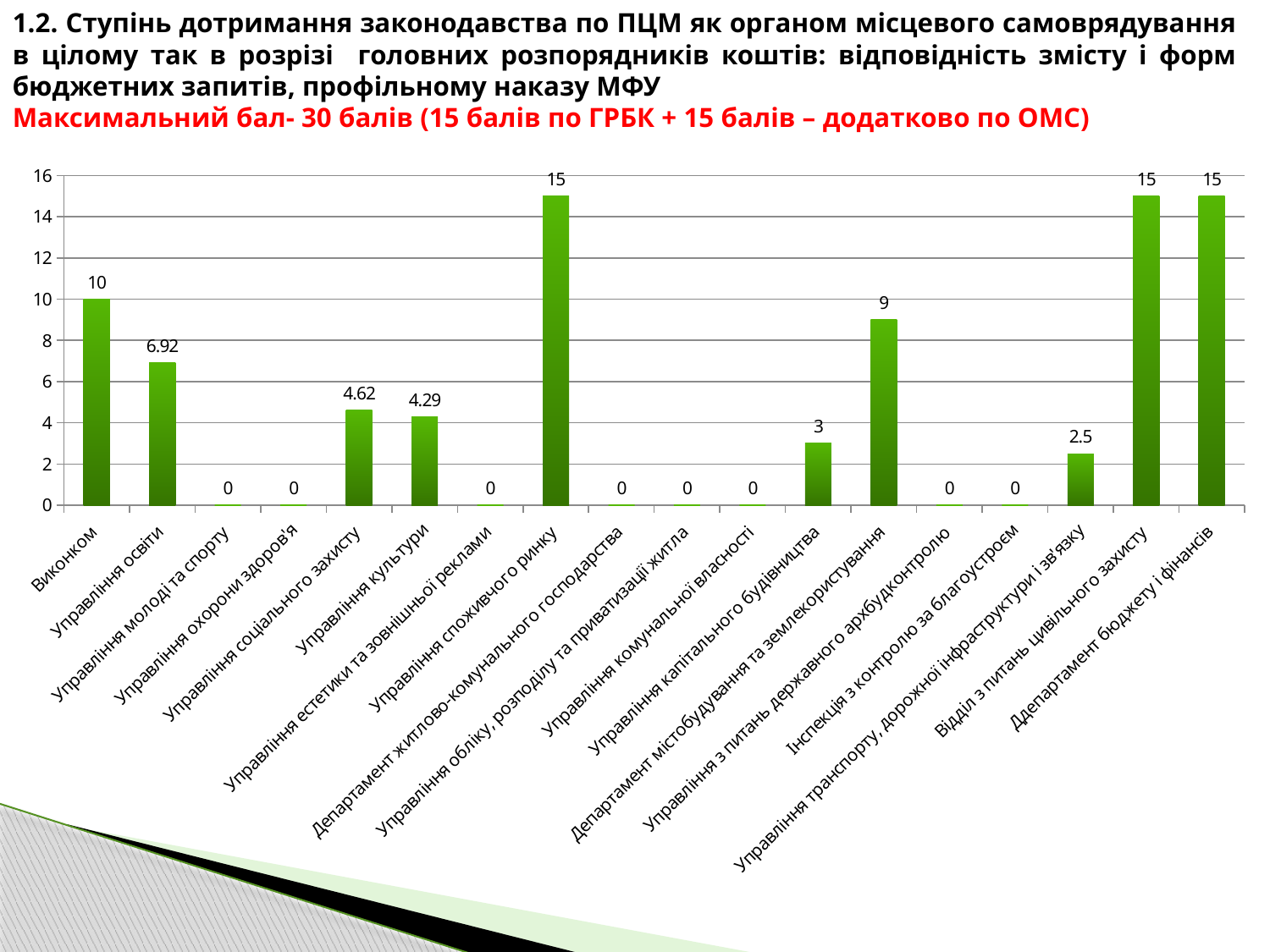
What is the value for Управління транспорту, дорожньої інфраструктури і зв'язку? 2.5 What is the maximum value shown on the vertical axis of the chart? 16 What is the value for Управління культури? 4.29 How many categories are shown on the x axis of the chart? 18 What is the difference between the values for Виконком and Управління освіти? 3.08 What is the highest value shown on the chart? 15 Which is larger, the value for Управління капітального будівництва or the value for Управління транспорту, дорожньої інфраструктури і зв'язку? Управління капітального будівництва What is the value for Виконком? 10 What is the value for Управління соціального захисту? 4.62 What is the value for Управління освіти? 6.92 What is the value for Департамент містобудування та землекористування? 9 What kind of chart is shown on the slide? bar chart